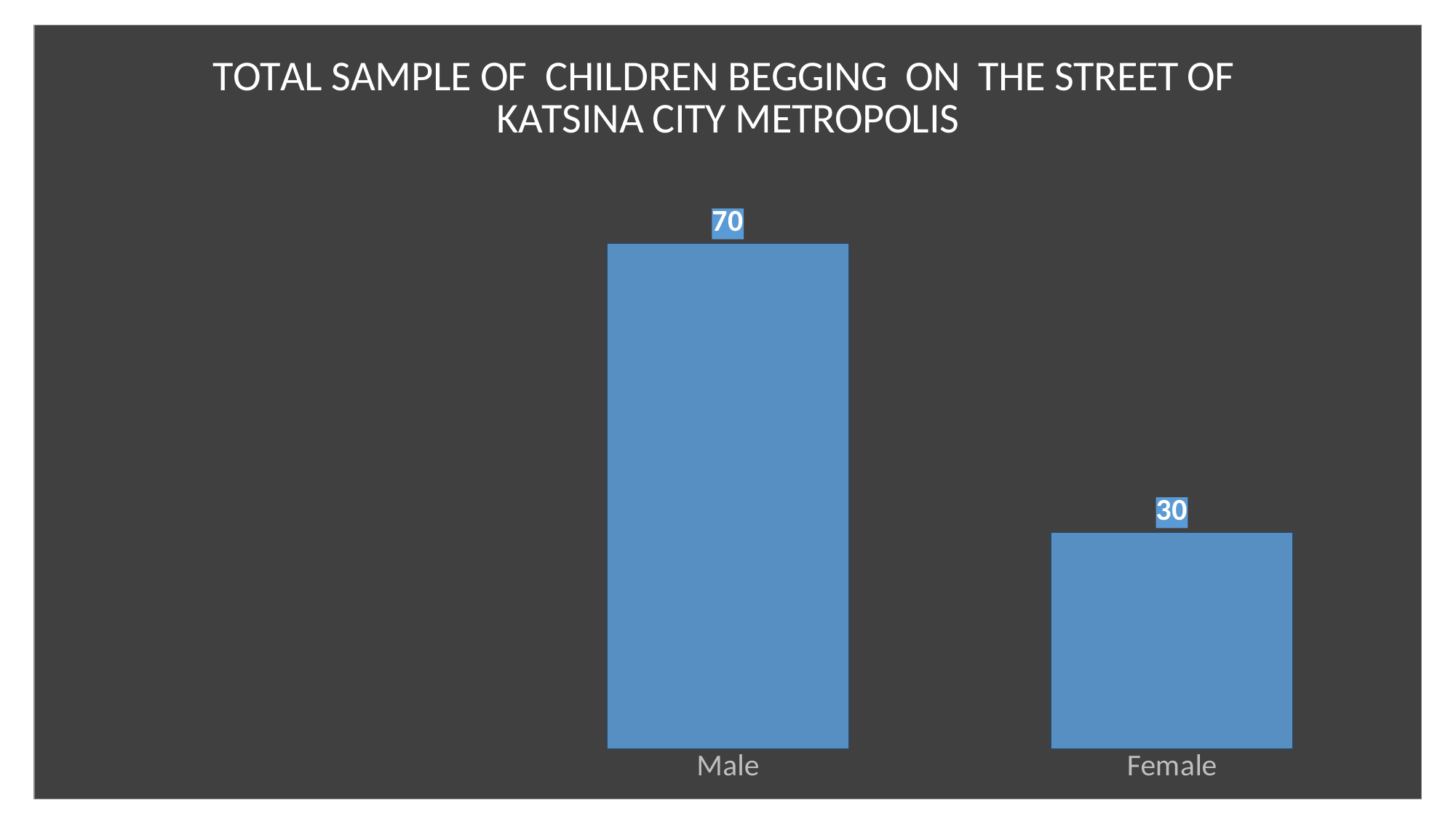
Which category has the highest value? Male What is the difference between the values for Male and Female? 40 What colour are the bars in the chart? Blue Which category has the lowest value? Female How many categories are shown in the chart? 2 What is the value for Male? 70 What is the title of the chart? TOTAL SAMPLE OF CHILDREN BEGGING ON THE STREET OF KATSINA CITY METROPOLIS What kind of chart is shown on the slide? Bar chart Which is larger, the value for Male or the value for Female? Male What is the total of the values for Male and Female? 100 What is the value for Female? 30